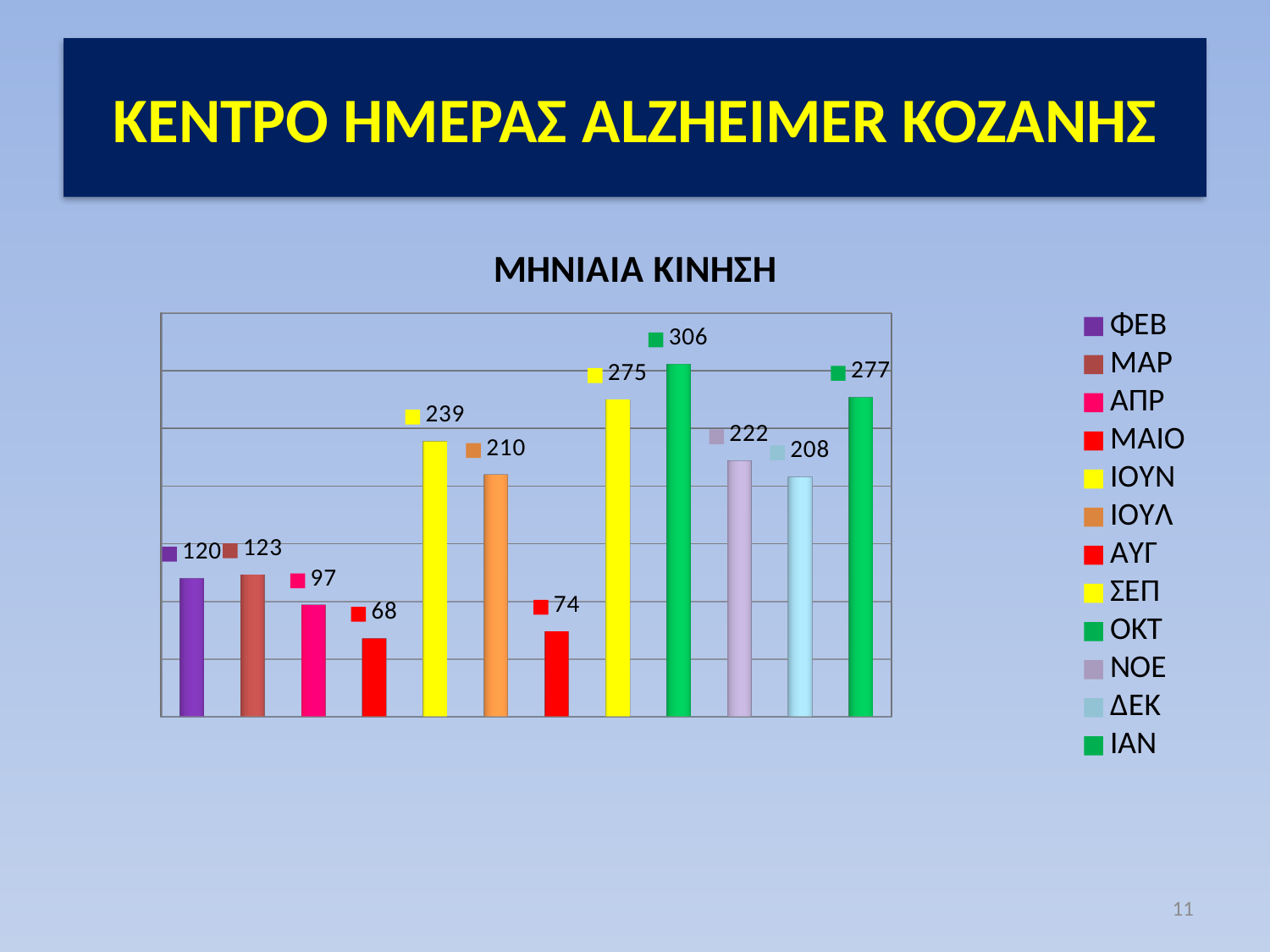
What is the difference between the values for ΟΚΤ and ΣΕΠ in the ΜΗΝΙΑΙΑ ΚΙΝΗΣΗ chart? 31 What is the value for ΙΟΥΛ in the ΜΗΝΙΑΙΑ ΚΙΝΗΣΗ chart? 210 Which month has the lowest value in the ΜΗΝΙΑΙΑ ΚΙΝΗΣΗ chart? ΜΑΙΟ What is the difference between the values for ΙΟΥΝ and ΜΑΙΟ in the ΜΗΝΙΑΙΑ ΚΙΝΗΣΗ chart? 171 What is the value for ΟΚΤ in the ΜΗΝΙΑΙΑ ΚΙΝΗΣΗ chart? 306 What kind of chart is the ΜΗΝΙΑΙΑ ΚΙΝΗΣΗ chart? Bar chart What is the title of the chart on the slide? ΜΗΝΙΑΙΑ ΚΙΝΗΣΗ Which is larger in the ΜΗΝΙΑΙΑ ΚΙΝΗΣΗ chart, the value for ΝΟΕ or the value for ΔΕΚ? ΝΟΕ Which is larger in the ΜΗΝΙΑΙΑ ΚΙΝΗΣΗ chart, the value for ΙΑΝ or the value for ΣΕΠ? ΙΑΝ How many entries does the legend of the ΜΗΝΙΑΙΑ ΚΙΝΗΣΗ chart list? 12 What is the value for ΑΠΡ in the ΜΗΝΙΑΙΑ ΚΙΝΗΣΗ chart? 97 Which month has the highest value in the ΜΗΝΙΑΙΑ ΚΙΝΗΣΗ chart? ΟΚΤ